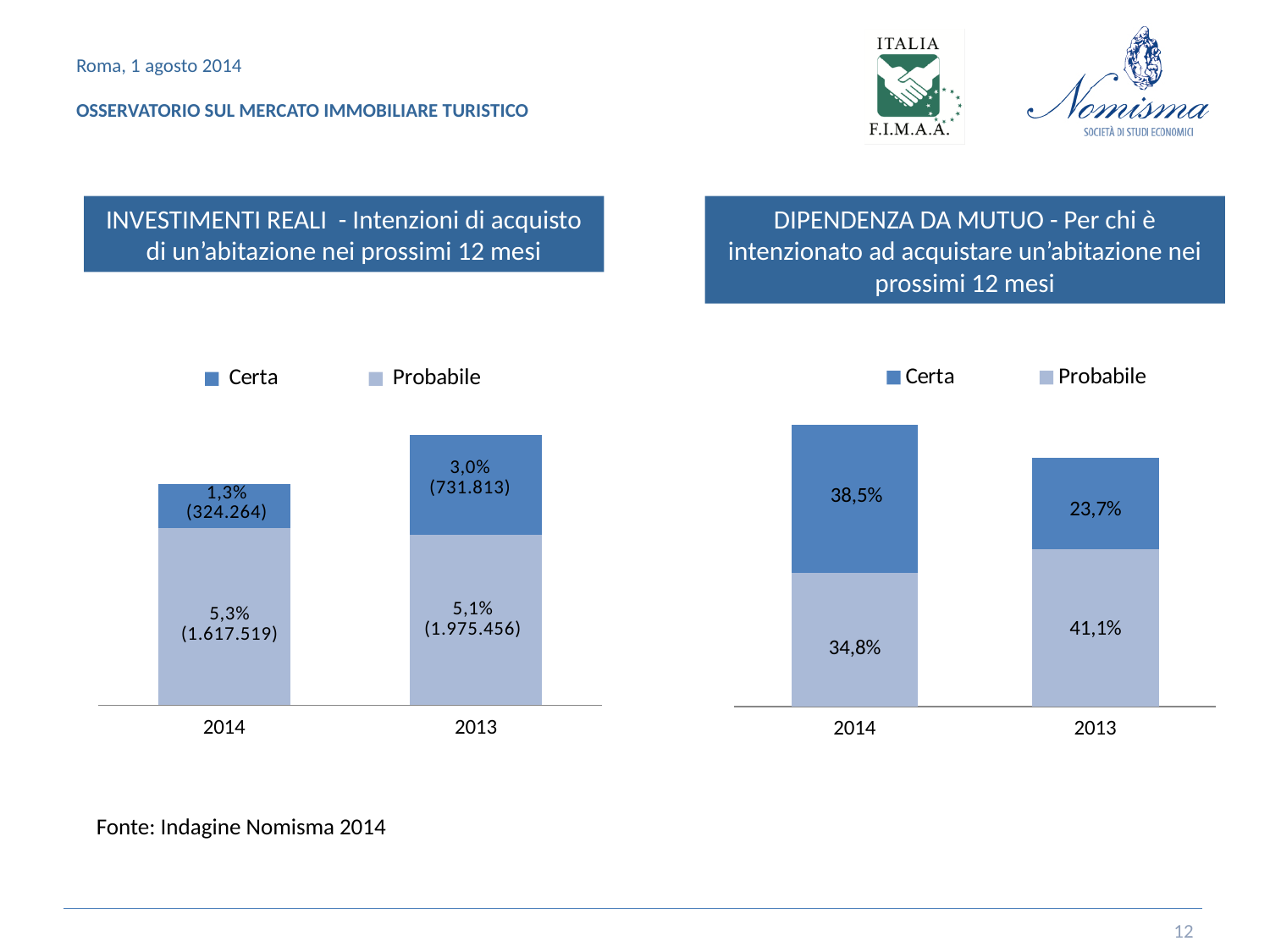
In the INVESTIMENTI REALI chart, which year has the higher Certa value? 2013 In the DIPENDENZA DA MUTUO chart, what is the Probabile value for 2014? 34,8% In the DIPENDENZA DA MUTUO chart, which year has the higher Probabile value? 2013 In the INVESTIMENTI REALI chart, what absolute number is shown in parentheses for the Certa segment in 2013? 731.813 In the DIPENDENZA DA MUTUO chart, what is the total of the stacked bar for 2014? 73,3% In the INVESTIMENTI REALI chart, what is the total of the stacked bar for 2013? 8,1% In the DIPENDENZA DA MUTUO chart, what is the Certa value for 2013? 23,7% In the INVESTIMENTI REALI chart, what is the Probabile value for 2013? 5,1% How many series does the legend of the DIPENDENZA DA MUTUO chart list? 2 What kind of chart is the INVESTIMENTI REALI chart? Stacked bar chart In the INVESTIMENTI REALI chart, what is the Certa value for 2014? 1,3% In the DIPENDENZA DA MUTUO chart, what is the difference between the Certa values for 2014 and 2013? 14,8 percentage points